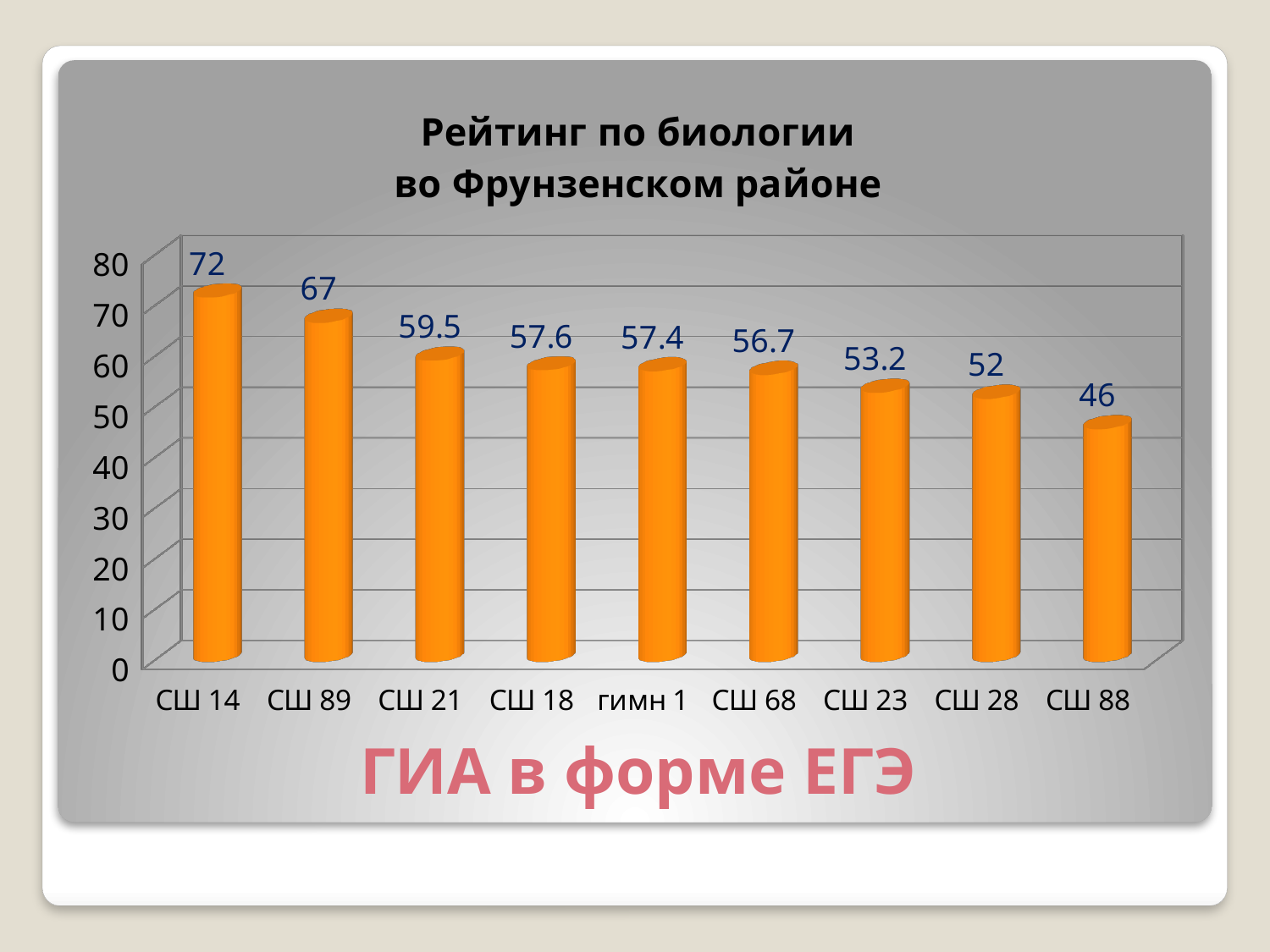
Is the value for СШ 68 greater or less than 50? greater What is the value for гимн 1? 57.4 What is the value for СШ 14? 72 What is the value for СШ 23? 53.2 Which school has the lowest value? СШ 88 What is the difference between the values for СШ 89 and СШ 21? 7.5 How many schools are shown on the chart? 9 What kind of chart is shown on the slide? bar chart Do the values rise or fall from left to right along the x axis? fall What is the difference between the values for СШ 14 and СШ 88? 26 Which school has the highest value? СШ 14 Which is larger, the value for СШ 89 or the value for СШ 28? СШ 89